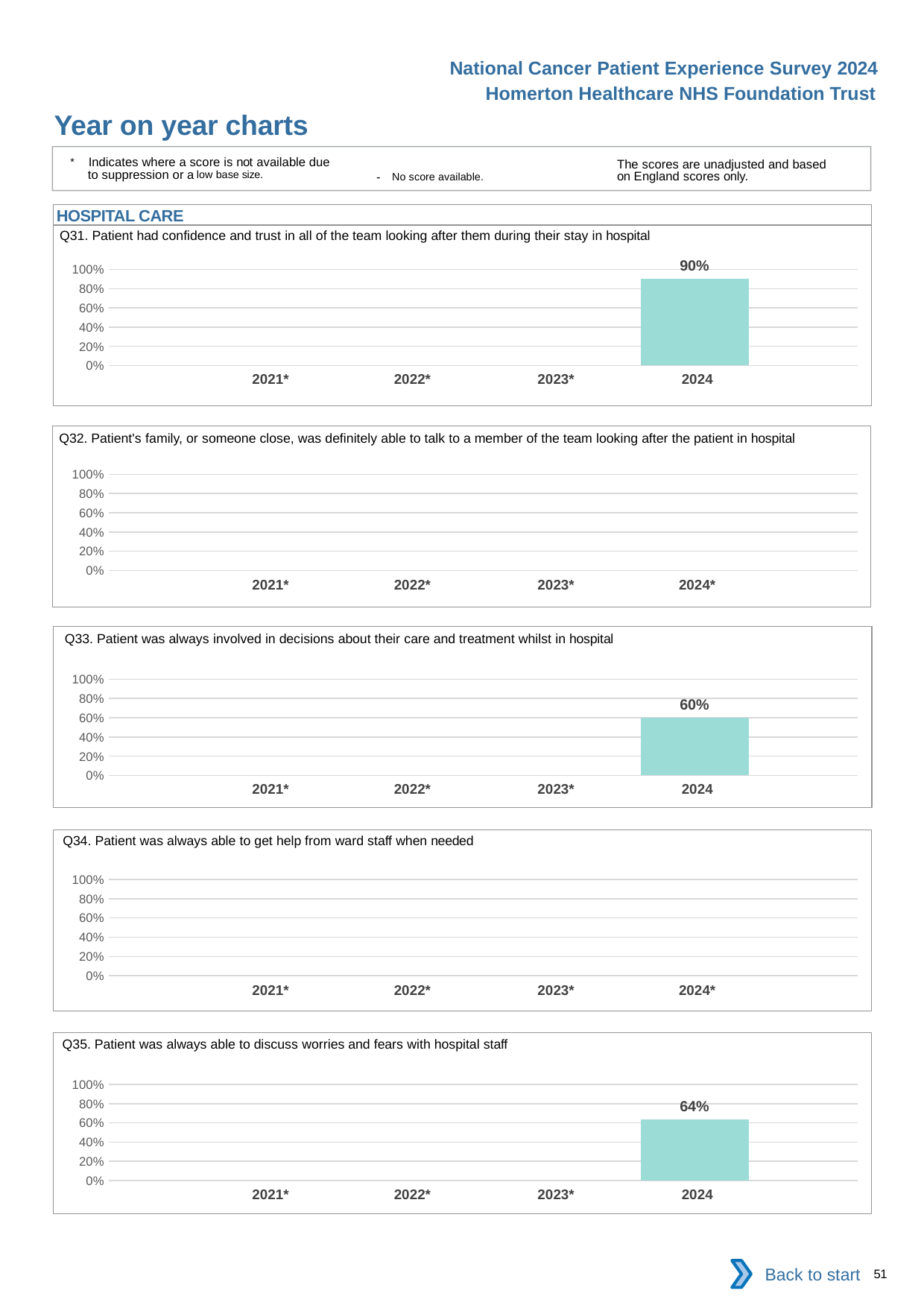
Which chart shows a higher 2024 value, the Q33 chart or the Q35 chart? Q35 In the Q31 chart, is the value for 2024 greater or less than 80%? greater How many year categories are shown on the x axis of the Q32 chart? 4 In the Q31 chart, what is the value for 2024? 90% How many charts on the slide show a bar for 2024? 3 What kind of chart is the Q31 chart? bar chart In the Q34 chart, which years are marked with an asterisk? 2021, 2022, 2023, 2024 What is the difference between the 2024 value in the Q31 chart and the 2024 value in the Q33 chart? 30% In the Q35 chart, what is the value for 2024? 64% In the Q33 chart, is the value for 2024 greater or less than 80%? less What is the section heading above the charts on the slide? HOSPITAL CARE In the Q33 chart, what is the value for 2024? 60%